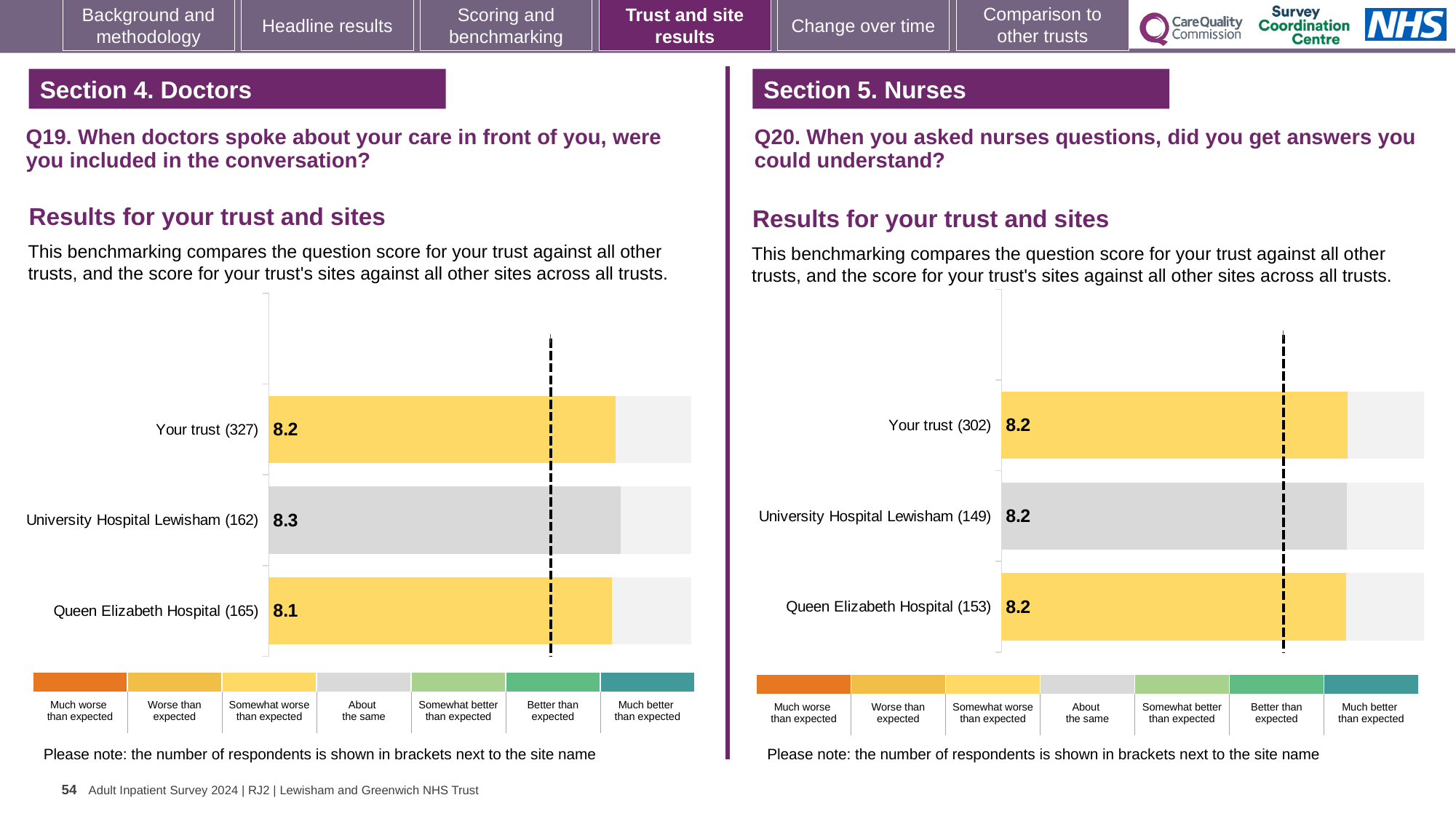
In the Q19 chart on the left, what is the score for Your trust? 8.2 In the Q19 chart on the left, which has the larger score, Your trust or University Hospital Lewisham? University Hospital Lewisham In the Q19 chart on the left, what is the score for Queen Elizabeth Hospital? 8.1 In the Q19 chart on the left, what is the difference between the scores for University Hospital Lewisham and Queen Elizabeth Hospital? 0.2 In the Q19 chart on the left, which benchmark category does the colour of the Your trust bar represent according to the legend? Somewhat worse than expected How many bars are plotted in the Q20 chart on the right? 3 In the Q20 chart on the right, what is the score for Queen Elizabeth Hospital? 8.2 What type of chart is used for the Q19 results on the left? Bar chart In the Q19 chart on the left, which site or trust has the lowest score? Queen Elizabeth Hospital In the Q19 chart on the left, what is the score for University Hospital Lewisham? 8.3 In the Q19 chart on the left, which site or trust has the highest score? University Hospital Lewisham In the Q20 chart on the right, what is the score for Your trust? 8.2